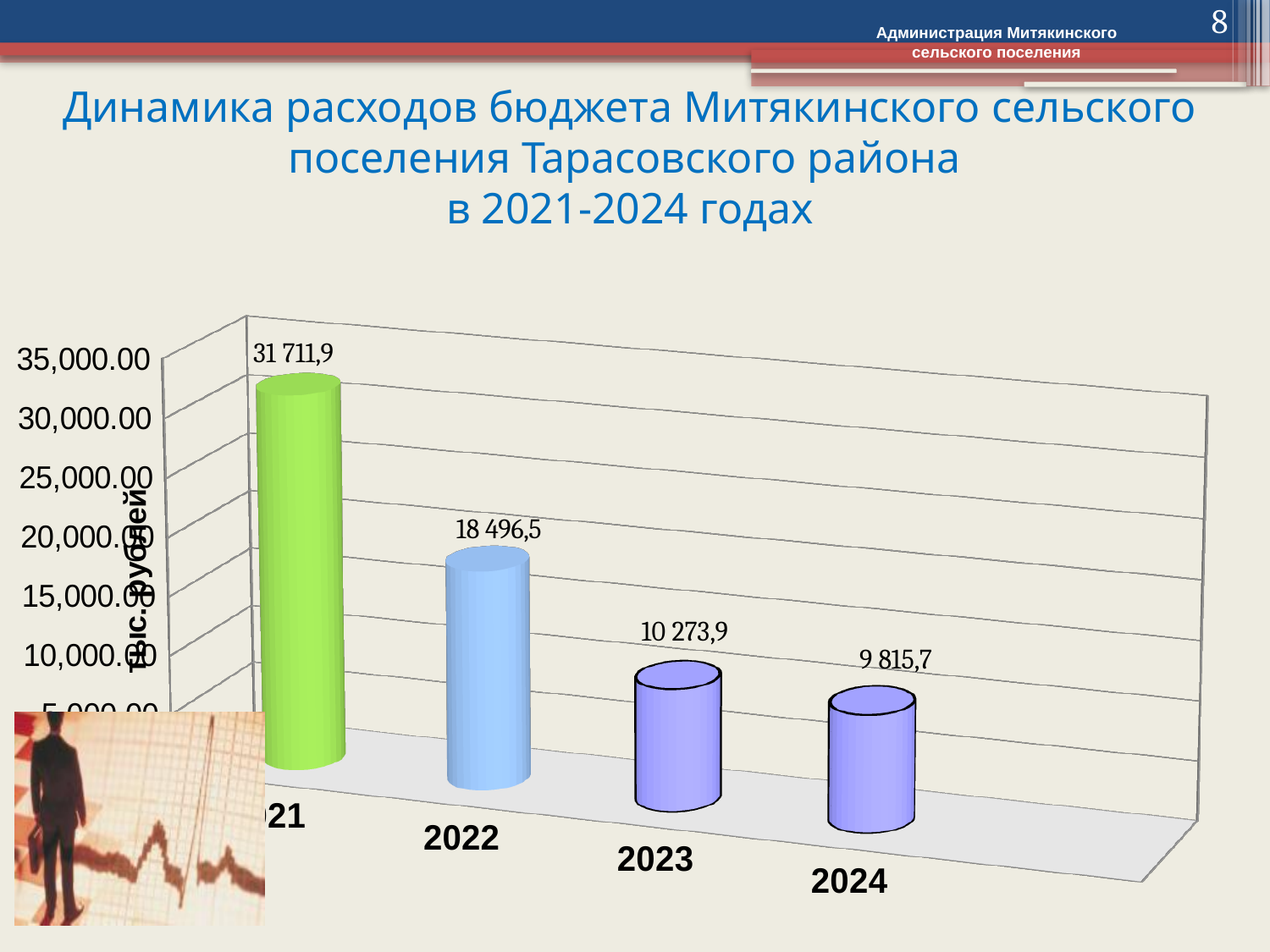
What is the value shown for 2023? 10 273,9 What kind of chart is shown on the slide? bar chart What is the value shown for 2021? 31 711,9 What is the value shown for 2024? 9 815,7 What is the difference between the values for 2023 and 2024? 458,2 Which year has the lowest expenditure value? 2024 Which is larger, the value for 2022 or the value for 2023? 2022 What is the budget expenditure value shown for 2022? 18 496,5 Which year has the highest expenditure value? 2021 How many years (categories) are plotted on the chart? 4 What is the difference between the values for 2021 and 2022? 13 215,4 Do the values rise or fall from 2021 to 2024? fall